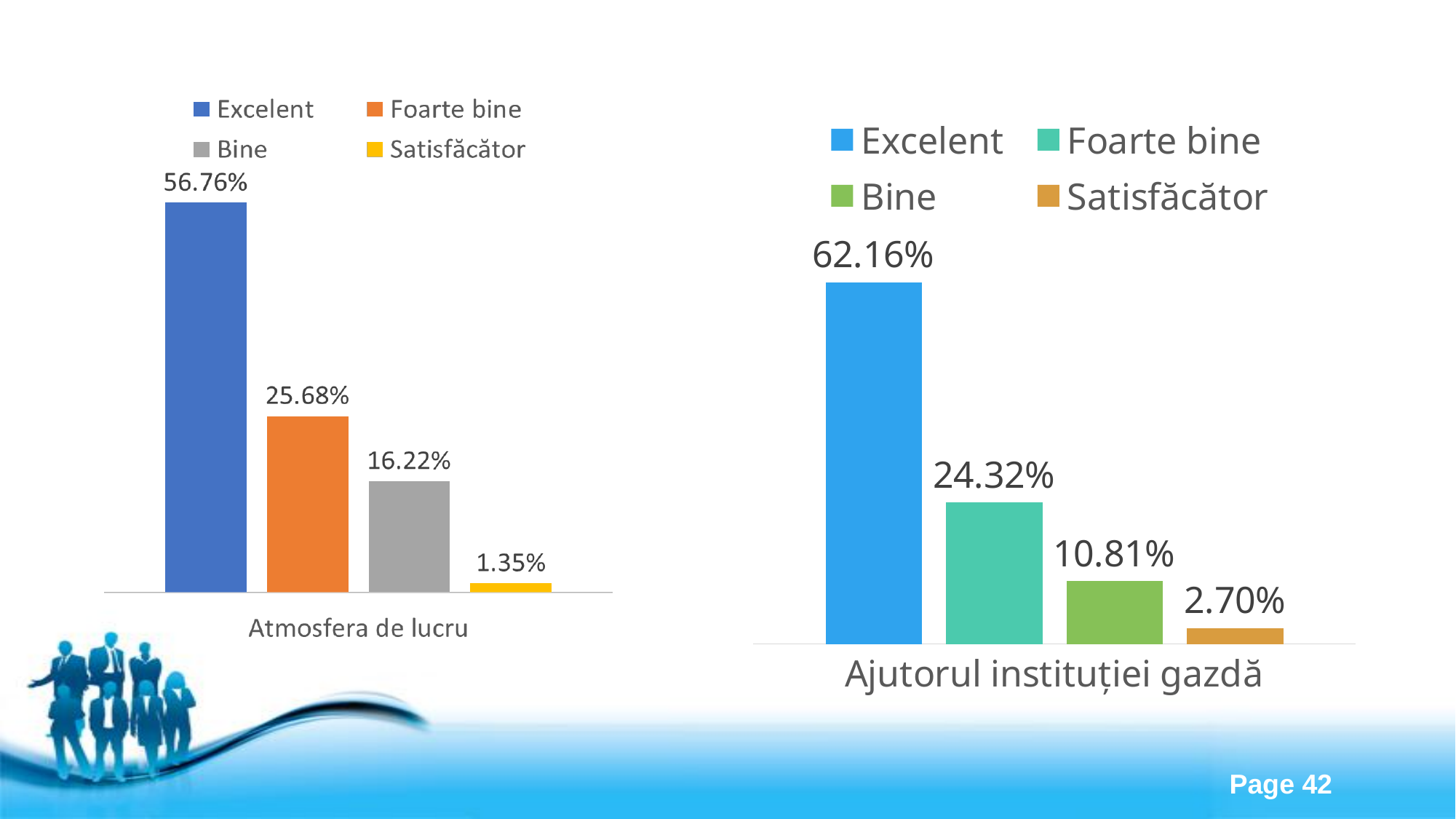
In the 'Ajutorul instituției gazdă' chart, what is the value for Foarte bine? 24.32% In the 'Atmosfera de lucru' chart, what is the value for Excelent? 56.76% In the 'Ajutorul instituției gazdă' chart, what is the value for Satisfăcător? 2.70% What kind of chart is the 'Atmosfera de lucru' chart? Bar chart In the 'Ajutorul instituției gazdă' chart, which category has the highest value? Excelent In the 'Atmosfera de lucru' chart, what is the value for Bine? 16.22% Which is larger: Bine in the 'Atmosfera de lucru' chart or Bine in the 'Ajutorul instituției gazdă' chart? Bine in the 'Atmosfera de lucru' chart How many series does the legend of the 'Ajutorul instituției gazdă' chart list? 4 In the 'Ajutorul instituției gazdă' chart, what is the difference between Bine and Satisfăcător? 8.11% In the 'Atmosfera de lucru' chart, what is the difference between Excelent and Foarte bine? 31.08% In the 'Atmosfera de lucru' chart, which category has the lowest value? Satisfăcător In the 'Atmosfera de lucru' chart, what colour is the Satisfăcător bar? Yellow